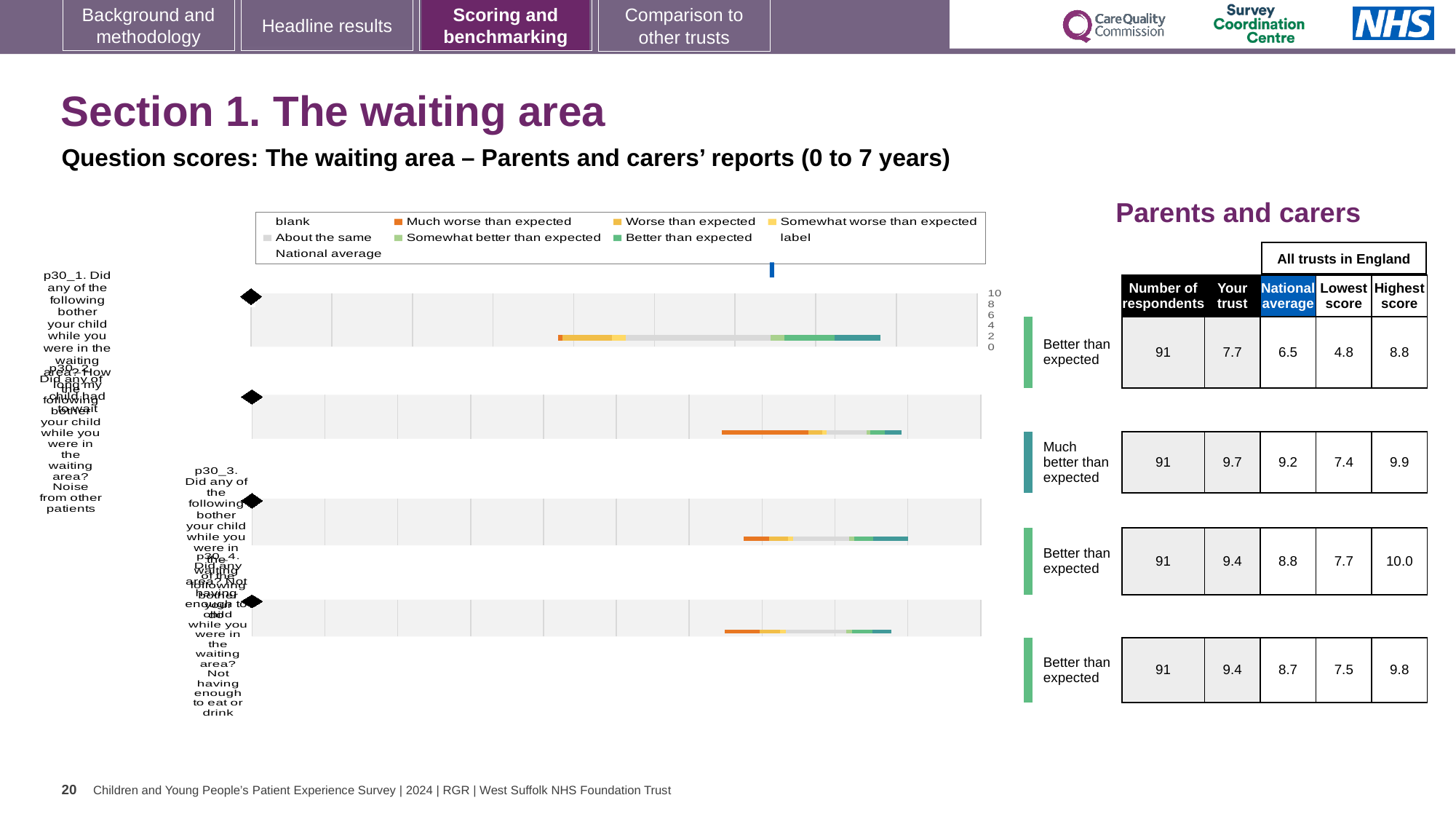
In the table beside the chart, which row has the lowest 'Your trust' score? p30_1 (7.7) In the table beside the chart, how many respondents are listed for each question row? 91 What kind of chart is shown on the slide? bar chart In the table beside the chart, which row has the highest 'Your trust' score? p30_2 (9.7) How many question rows (bars) are plotted in the chart? 4 In the table beside the chart, what is the national average for the second row (p30_2, noise from other patients)? 9.2 In the table beside the chart, is the 'Your trust' score for the third row (9.4) larger or smaller than its national average (8.8)? larger In the table beside the chart, what is the difference between the 'Your trust' score and the national average for the first row (7.7 vs 6.5)? 1.2 Which legend entry is shown in orange in the chart? Much worse than expected What is the highest value shown on the chart's axis? 10 How many entries does the chart's legend list? 9 In the table beside the chart, what is the 'Your trust' score for the first row (p30_1, waiting area bother)? 7.7